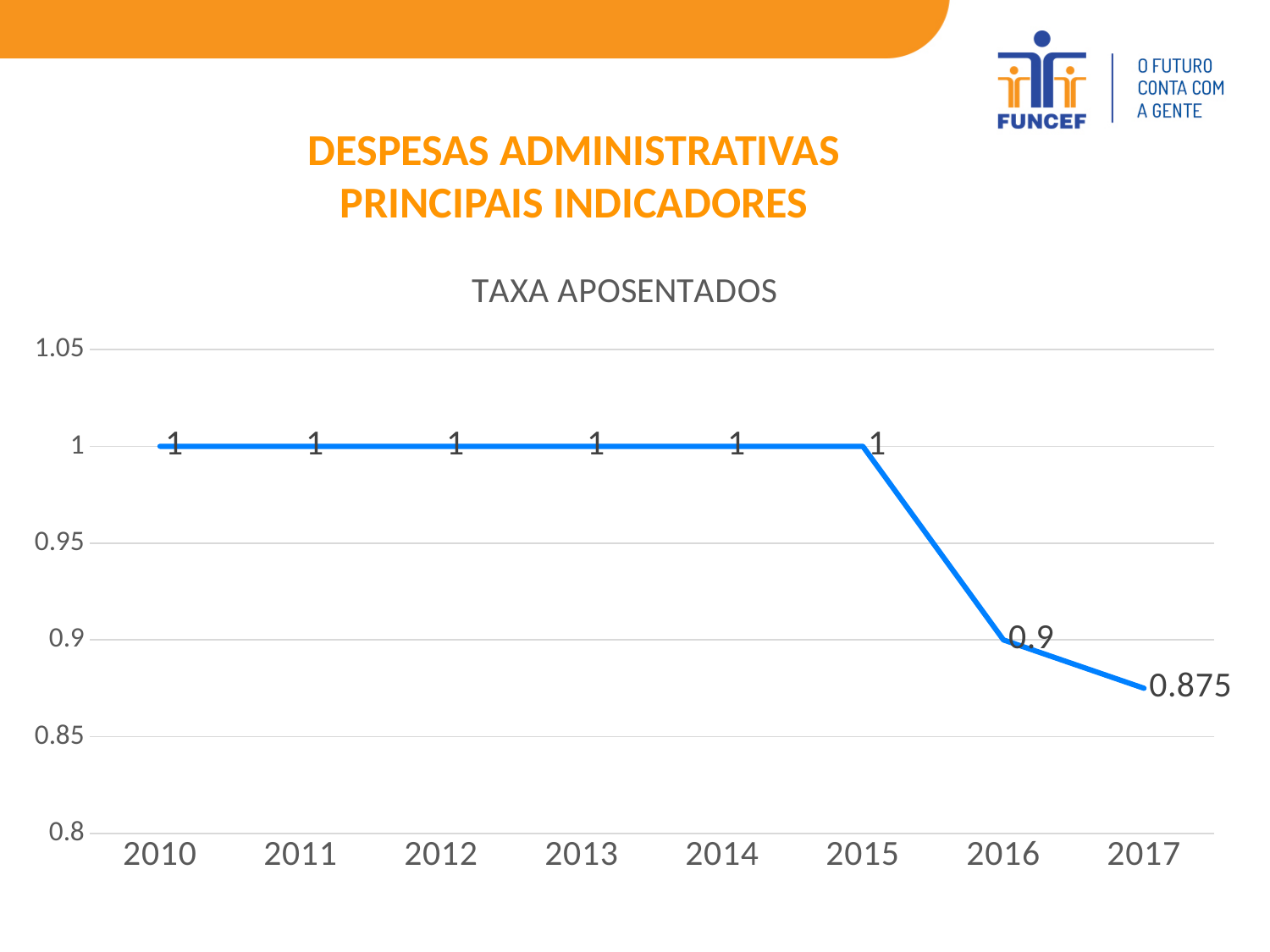
What is the value for 2016? 0.9 What is the difference between the values for 2015 and 2016? 0.1 Which year has the lowest value? 2017 Is the value for 2017 greater or less than 0.9? less What is the value for 2017? 0.875 Do the values rise or fall from 2015 to 2017? fall How many years are plotted on the chart? 8 What is the title of the chart? TAXA APOSENTADOS What kind of chart is shown? line chart What is the value for 2013? 1 Which is larger, the value for 2016 or the value for 2017? 2016 What is the difference between the values for 2016 and 2017? 0.025